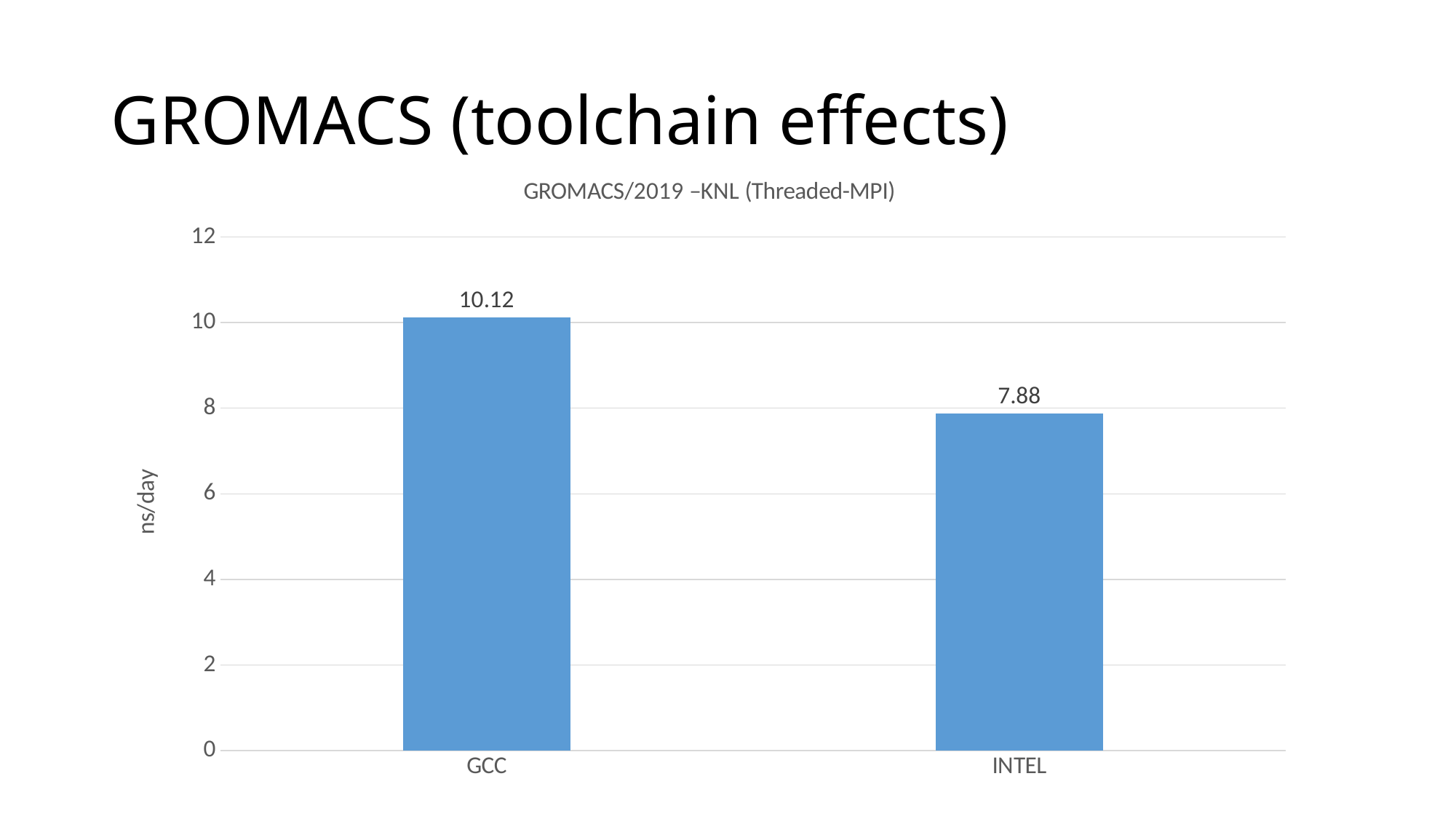
Is the value for INTEL greater or less than 8? less Which is larger, the value for GCC or the value for INTEL? GCC What kind of chart is shown on the slide? bar chart Which category has the highest value? GCC What is the label of the y axis? ns/day Is the value for GCC greater or less than 10? greater How many categories are shown on the chart? 2 What is the difference between the values for GCC and INTEL? 2.24 What is the value for INTEL? 7.88 What is the title of the chart? GROMACS/2019 –KNL (Threaded-MPI) Which category has the lowest value? INTEL What is the value for GCC? 10.12